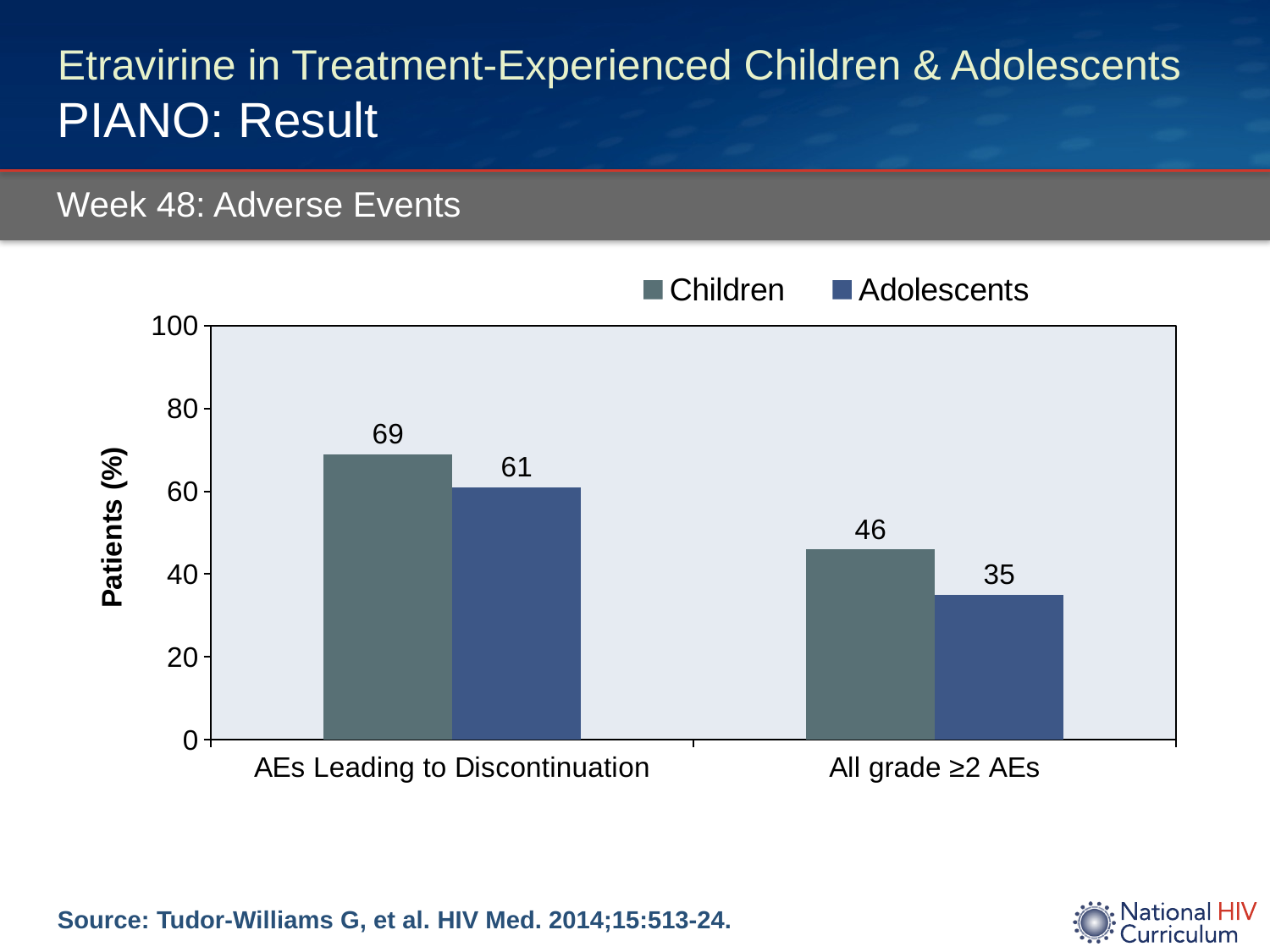
Which group and category has the highest value on the chart? Children, AEs Leading to Discontinuation What kind of chart is shown on the slide? Bar chart What is the label of the y axis? Patients (%) What is the difference between children and adolescents for AEs leading to discontinuation? 8 What is the difference between children and adolescents for all grade ≥2 AEs? 11 What percentage of adolescents had all grade ≥2 AEs? 35 Which group and category has the lowest value on the chart? Adolescents, All grade ≥2 AEs How many series does the legend list? 2 What percentage of children had all grade ≥2 AEs? 46 For all grade ≥2 AEs, which group has the higher value, children or adolescents? Children What percentage of children had AEs leading to discontinuation? 69 What percentage of adolescents had AEs leading to discontinuation? 61